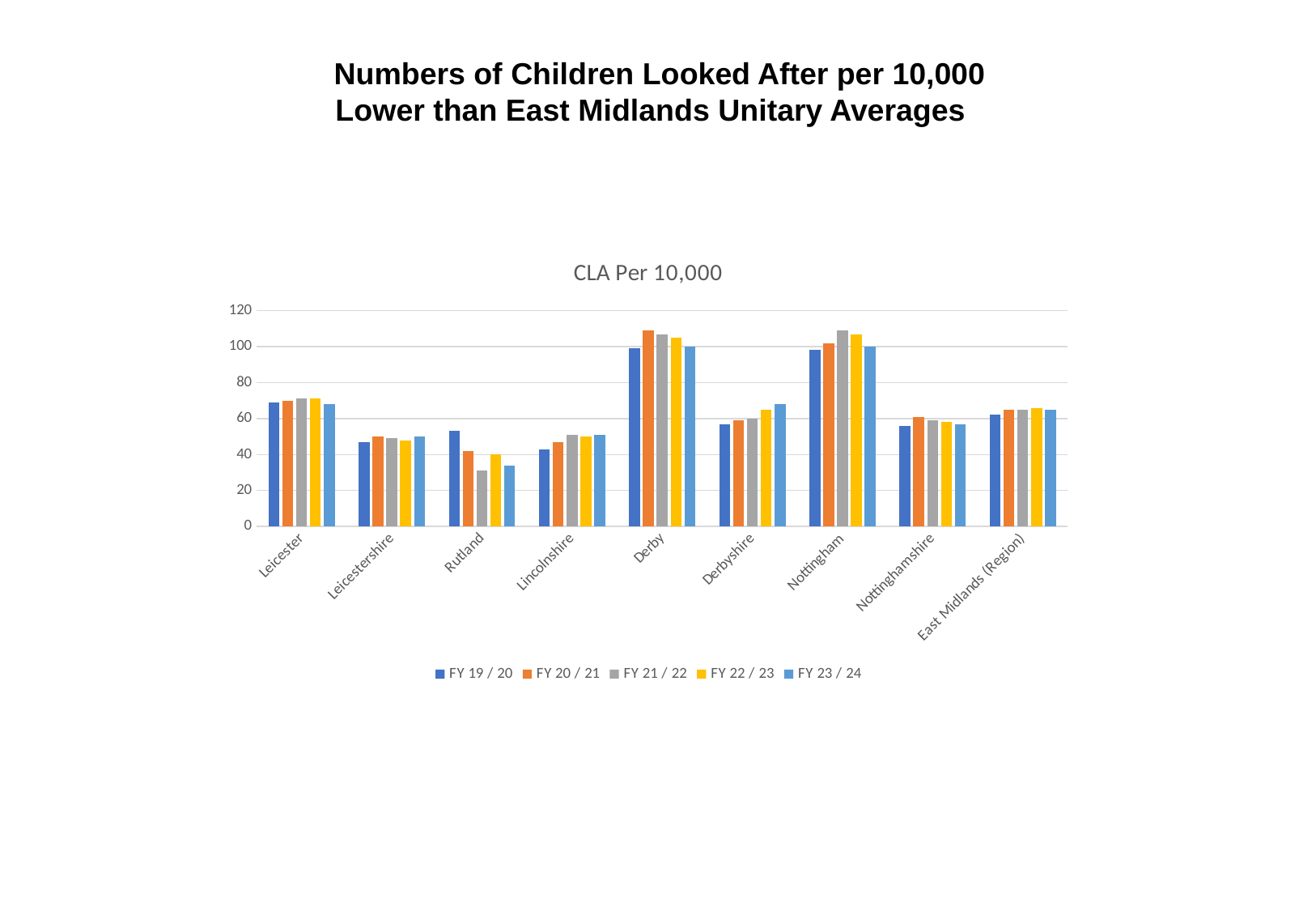
What kind of chart is shown on the slide? bar chart Which is larger for FY 19 / 20: Derby or Leicester? Derby What is the title of the chart? CLA Per 10,000 Is the value for Leicester in FY 19 / 20 greater or less than 60? greater How many series does the legend list? 5 Which category has the lowest value for FY 23 / 24? Rutland For Rutland, which is larger: FY 19 / 20 or FY 21 / 22? FY 19 / 20 Is the value for Rutland in FY 21 / 22 greater or less than 40? less Which legend entry is shown in orange? FY 20 / 21 Is the value for Derbyshire in FY 23 / 24 greater or less than 60? greater How many categories are shown on the x axis? 9